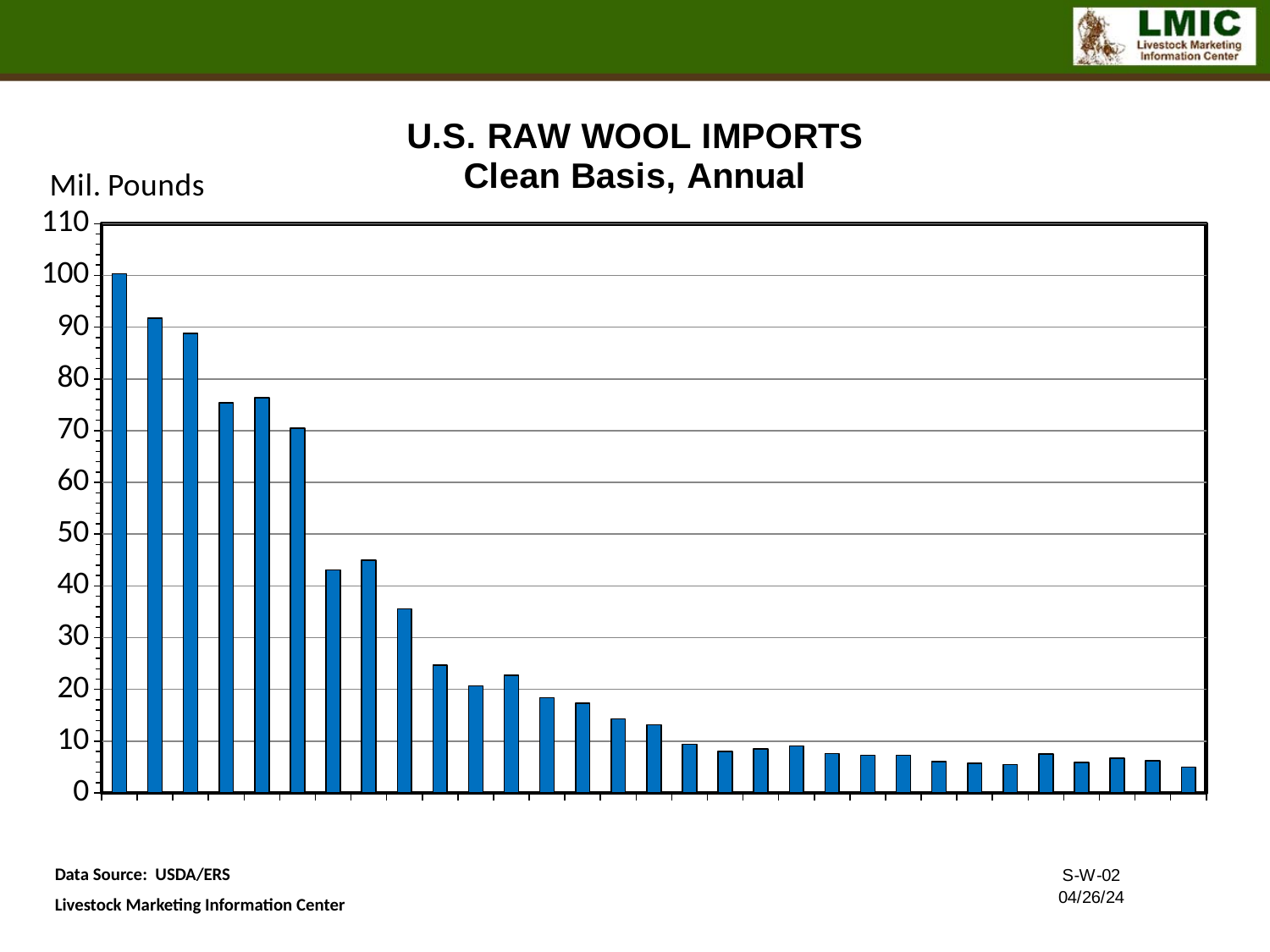
What kind of chart is shown on the slide? bar chart Which is larger, the leftmost bar or the rightmost bar? the leftmost bar What is the title of the chart? U.S. RAW WOOL IMPORTS Clean Basis, Annual Is the value of the rightmost bar greater or less than 10? less Is the value of the third bar from the left greater or less than 80? greater Do the values generally rise or fall from left to right across the chart? fall Is the value of the seventh bar from the left greater or less than 50? less Which bar is the highest in the chart? the leftmost (first) bar What unit is shown for the vertical axis of the chart? Mil. Pounds